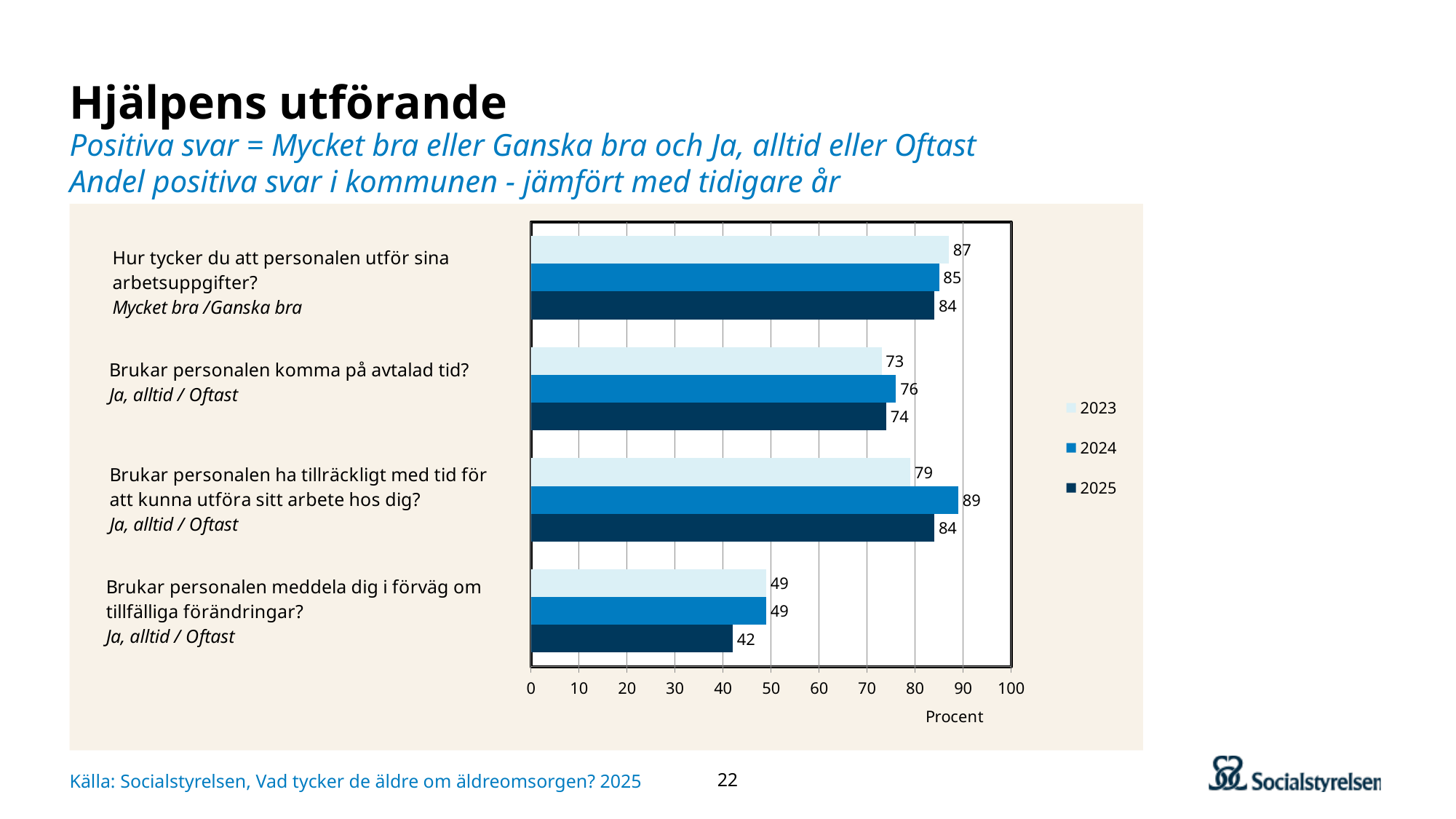
For "Brukar personalen komma på avtalad tid?", which year has the larger value, 2023 or 2024? 2024 What is the 2025 value for "Brukar personalen meddela dig i förväg om tillfälliga förändringar?"? 42 What is the 2024 value for "Brukar personalen ha tillräckligt med tid för att kunna utföra sitt arbete hos dig?"? 89 What is the 2023 value for "Hur tycker du att personalen utför sina arbetsuppgifter?"? 87 How many series does the legend list? 3 Which question has the lowest 2025 value? Brukar personalen meddela dig i förväg om tillfälliga förändringar? Which question has the highest 2024 value? Brukar personalen ha tillräckligt med tid för att kunna utföra sitt arbete hos dig? What is the label of the horizontal axis? Procent What is the difference between the 2024 and 2025 values for "Brukar personalen ha tillräckligt med tid för att kunna utföra sitt arbete hos dig?"? 5 How many questions (categories) are shown in the chart? 4 What kind of chart is shown on the slide? Bar chart Is the 2025 value for "Brukar personalen meddela dig i förväg om tillfälliga förändringar?" greater or less than 50? less